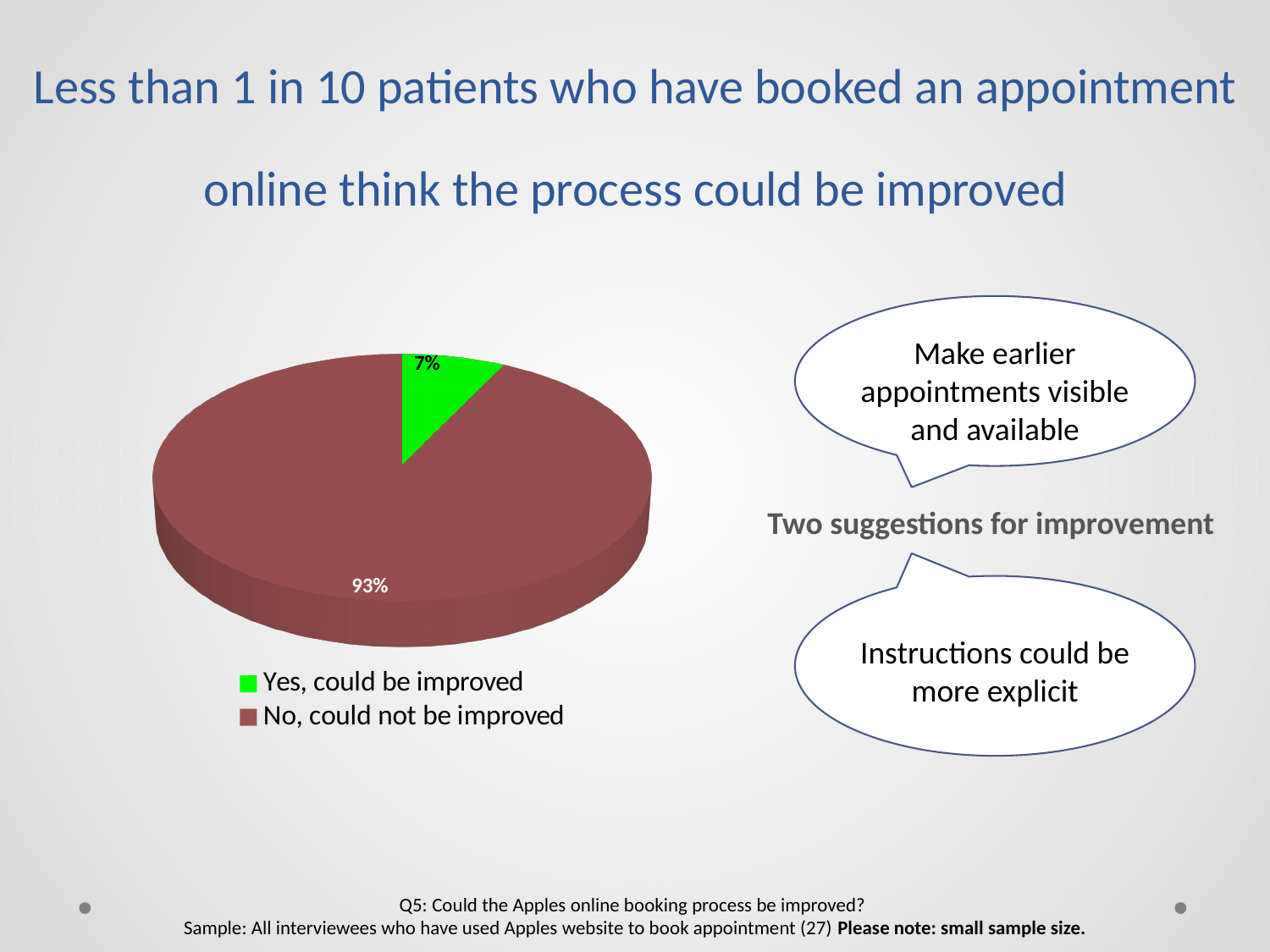
What is the difference in percentage points between 'No, could not be improved' and 'Yes, could be improved'? 86 How many entries does the legend list? 2 What percentage of patients said the online booking process could be improved? 7% What percentage of patients said the online booking process could not be improved? 93% How many categories does the pie chart show? 2 Which category has the smallest share of the pie? Yes, could be improved What is the sample size noted for the chart? 27 Which category has the largest share of the pie? No, could not be improved What share of the pie does the 'Yes, could be improved' slice represent? 7% What kind of chart is shown on the slide? Pie chart Which is larger: the share for 'Yes, could be improved' or 'No, could not be improved'? No, could not be improved What colour is the 'Yes, could be improved' slice? Green